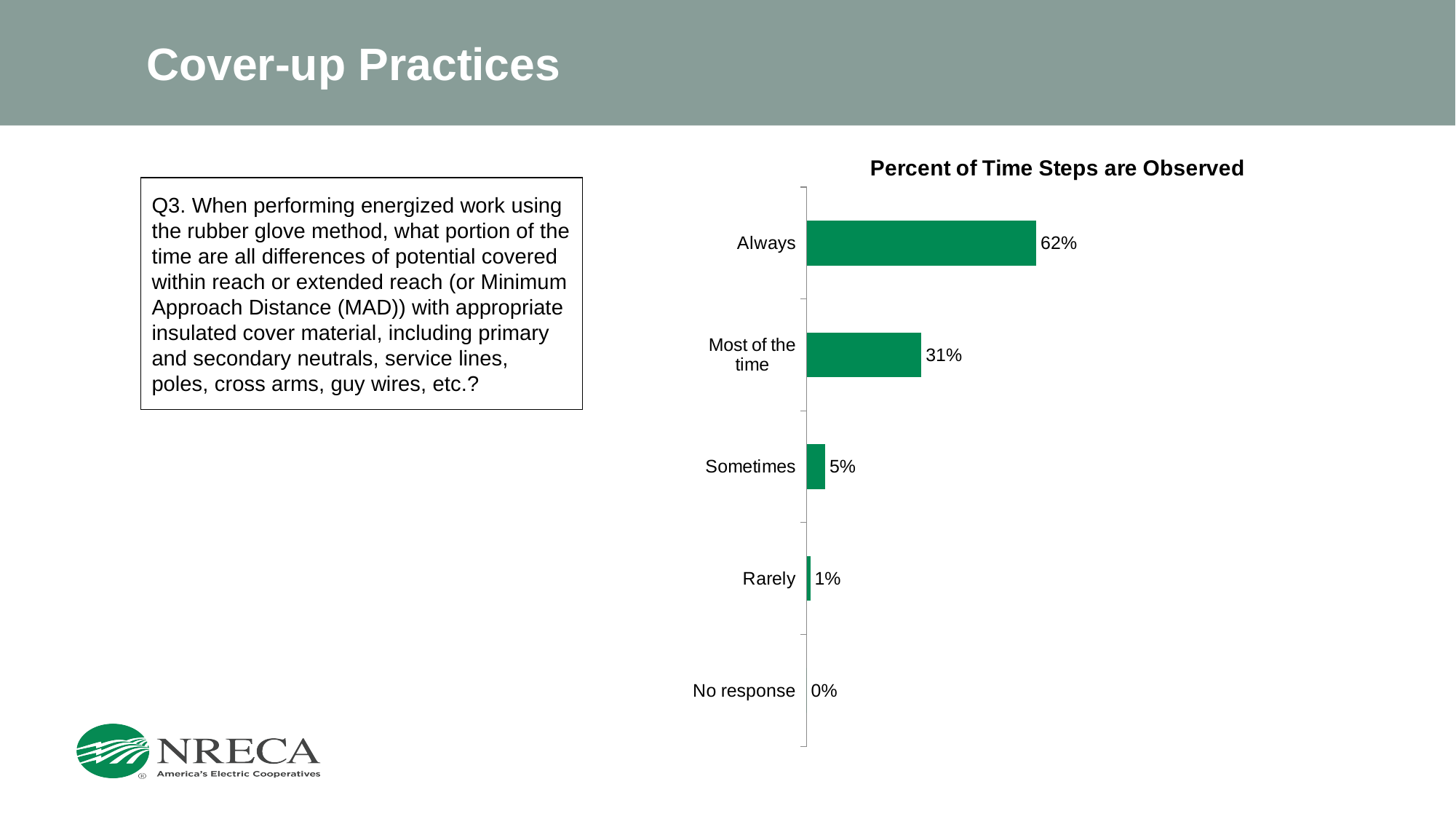
What is the title of the chart? Percent of Time Steps are Observed Which category has the highest percentage? Always What percentage is shown for "Rarely"? 1% Which is larger, the value for "Sometimes" or the value for "Rarely"? Sometimes What kind of chart is shown on the slide? Bar chart What percentage is shown for "Always"? 62% Which category has the lowest percentage? No response What percentage is shown for "Most of the time"? 31% How many categories are shown in the chart? 5 What percentage is shown for "Sometimes"? 5% What percentage is shown for "No response"? 0% What is the difference in percentage points between "Always" and "Most of the time"? 31